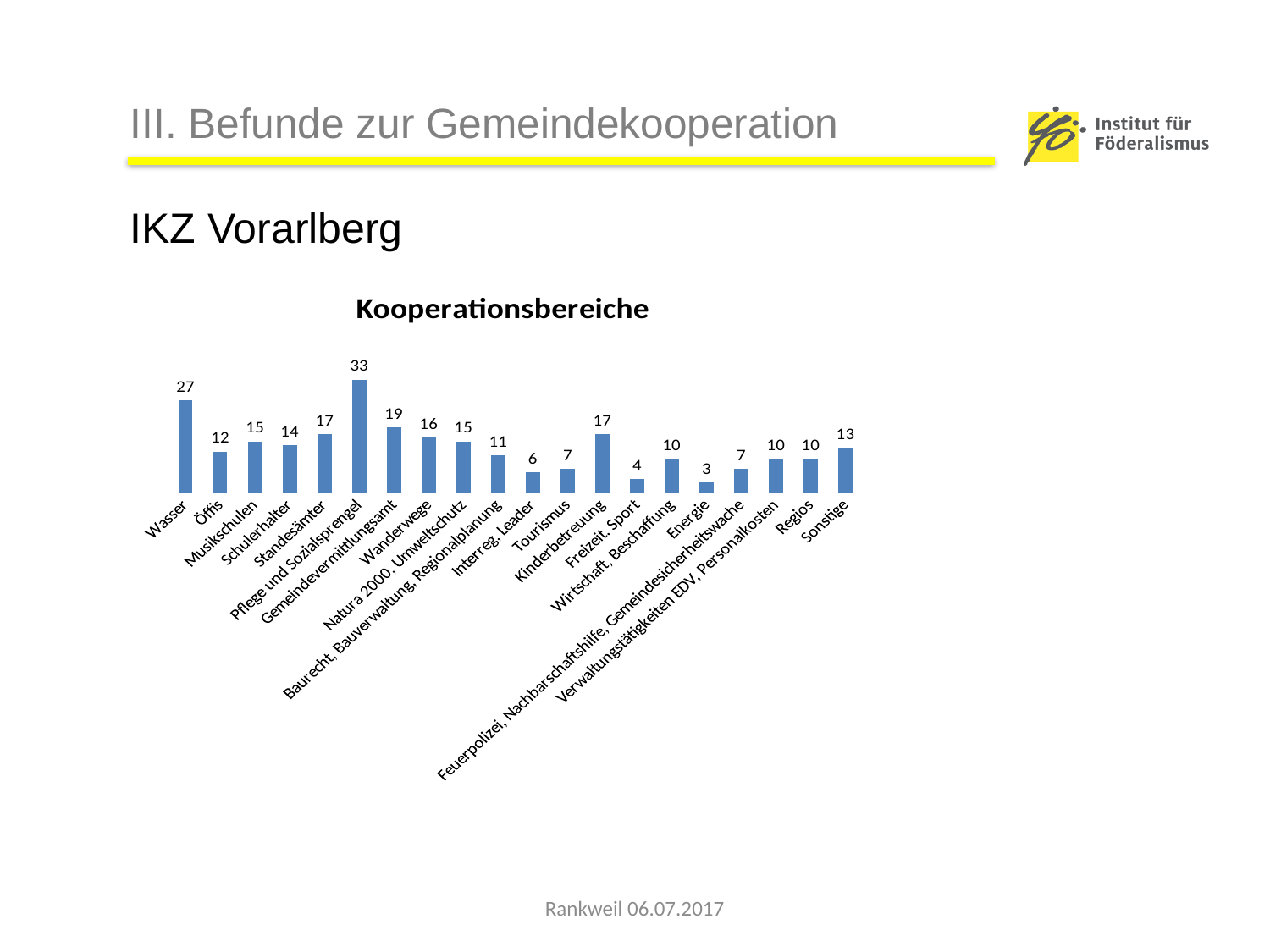
Which category has the highest value in the Kooperationsbereiche chart? Pflege und Sozialsprengel What is the title of the chart on the slide? Kooperationsbereiche What is the value for Wasser in the Kooperationsbereiche chart? 27 What is the value for Gemeindevermittlungsamt? 19 What is the difference between the values for Öffis and Freizeit, Sport? 8 What is the difference between the values for Pflege und Sozialsprengel and Wasser? 6 Which category has the lowest value in the Kooperationsbereiche chart? Energie What is the value for Kinderbetreuung in the Kooperationsbereiche chart? 17 What is the value for Sonstige? 13 How many categories are shown in the Kooperationsbereiche chart? 20 Which has a larger value, Wanderwege or Tourismus? Wanderwege What kind of chart is shown on the slide? Bar chart